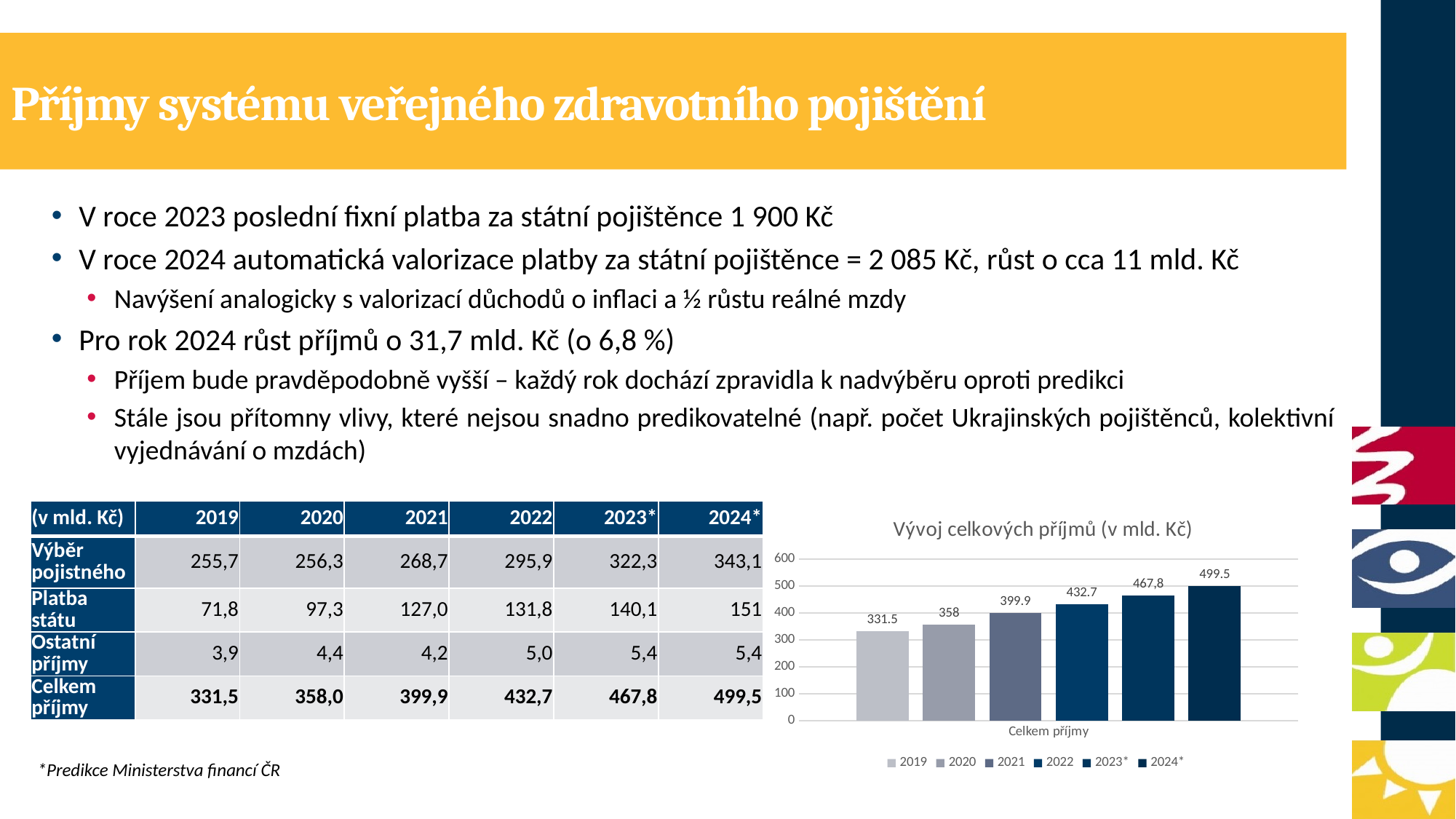
In the chart, what is the value for 2021? 399.9 In the chart, what is the value for 2022? 432.7 Do the values in the chart rise or fall from 2019 to 2024*? rise What is the title of the chart on the slide? Vývoj celkových příjmů (v mld. Kč) What type of chart is shown on the slide? bar chart How many series does the chart legend list? 6 In the chart, which is larger, the value for 2020 or the value for 2022? 2022 In the chart, what is the value for 2024*? 499.5 Which year has the lowest value in the chart? 2019 In the chart, what is the difference between the values for 2024* and 2019? 168 Which year has the highest value in the chart? 2024* In the chart, what is the value for 2019? 331.5